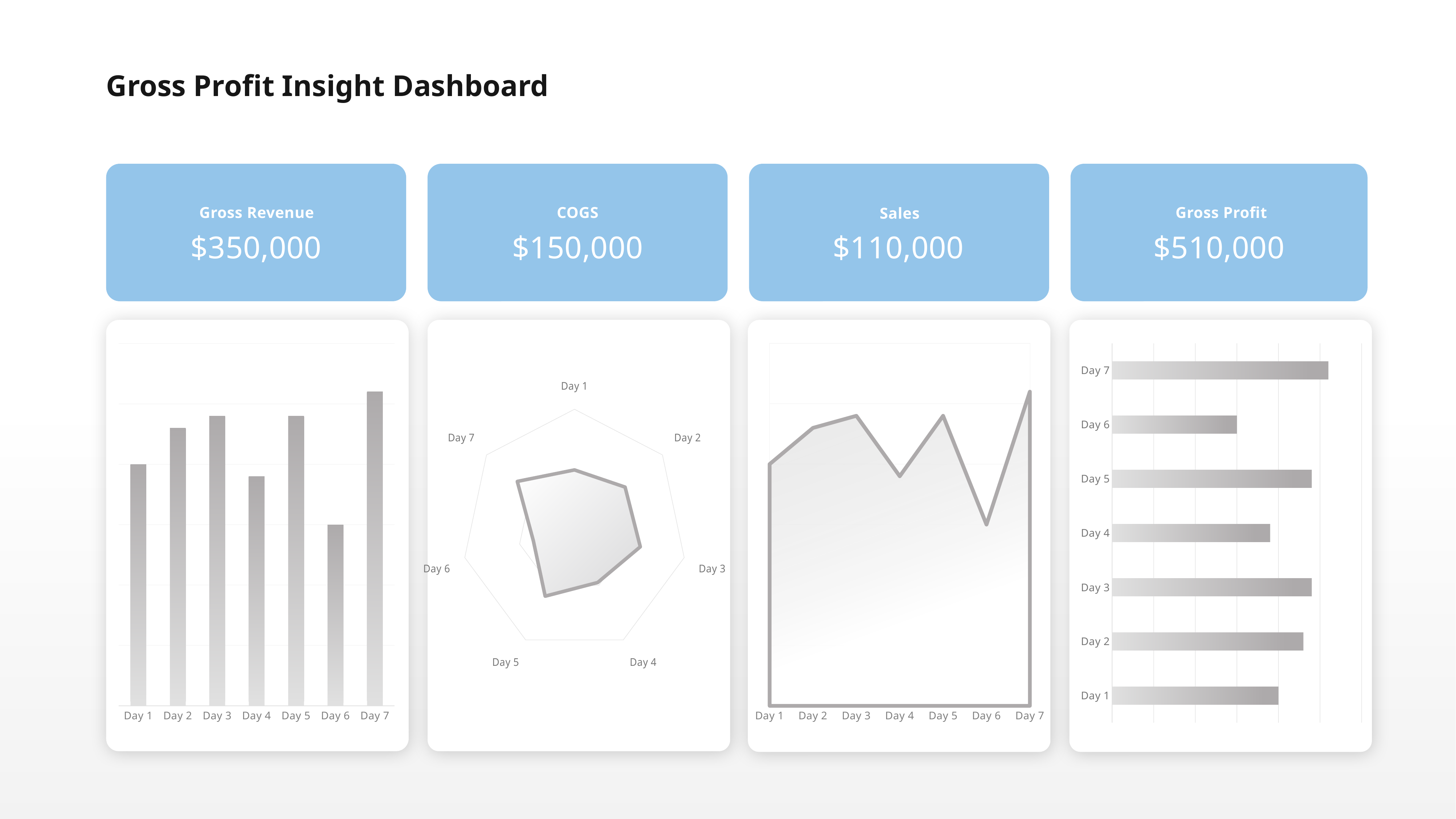
What kind of chart is the second chart from the left, below the COGS card? radar chart In the rightmost horizontal bar chart below the Gross Profit card, which day has the longest bar? Day 7 What kind of chart is the third chart from the left, below the Sales card? area chart In the leftmost bar chart below the Gross Revenue card, which is larger, Day 2 or Day 4? Day 2 In the rightmost horizontal bar chart below the Gross Profit card, which day has the shortest bar? Day 6 What kind of chart is the leftmost chart, below the Gross Revenue card? bar chart How many categories does the radar chart below the COGS card have? 7 In the area chart below the Sales card, does the value rise or fall from Day 5 to Day 6? fall In the leftmost bar chart below the Gross Revenue card, which day has the lowest bar? Day 6 In the leftmost bar chart below the Gross Revenue card, which day has the highest bar? Day 7 In the area chart below the Sales card, which day has the highest value? Day 7 How many days are shown on the x axis of the leftmost bar chart below the Gross Revenue card? 7